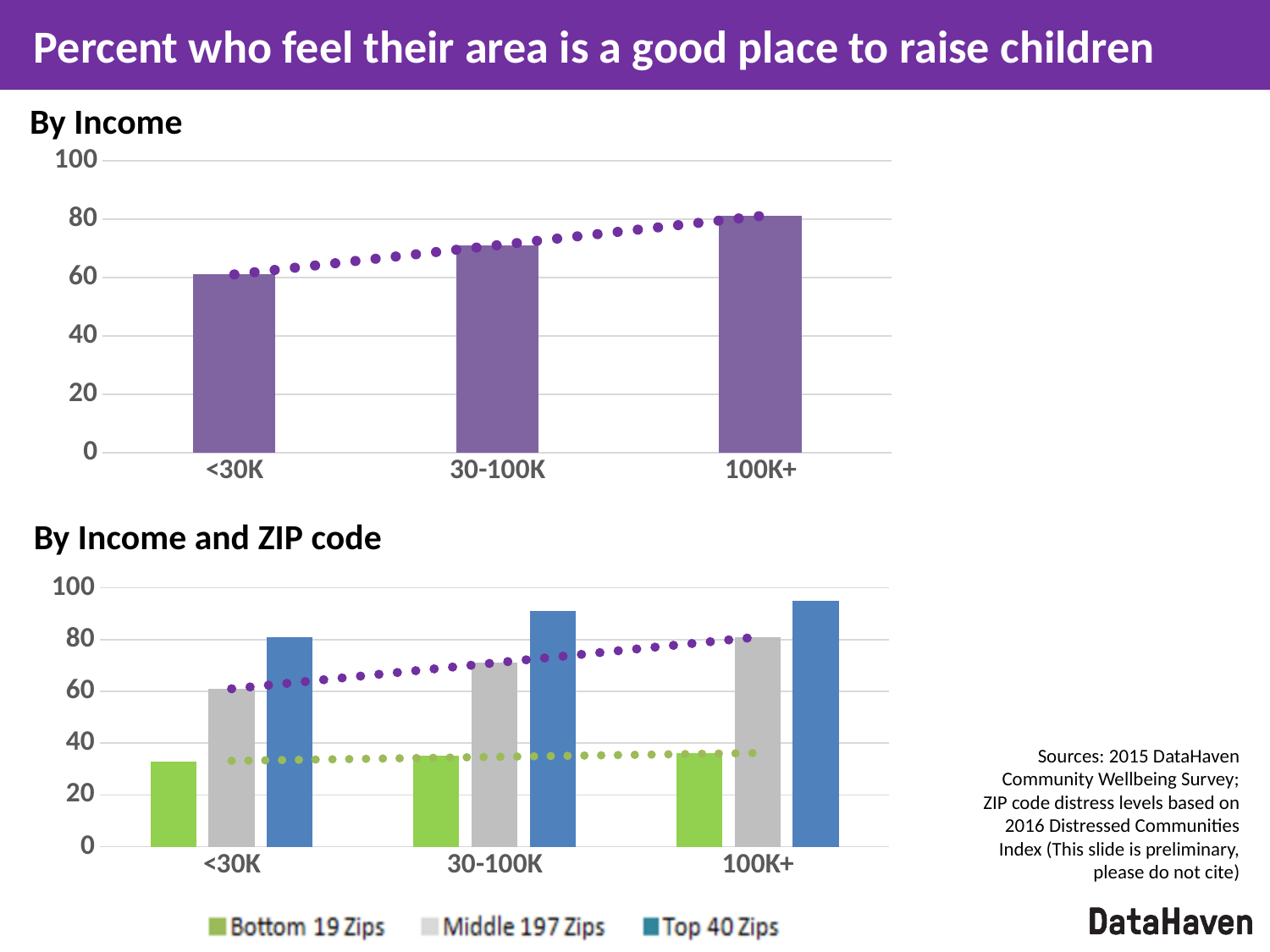
In the 'By Income and ZIP code' chart, is the value for Top 40 Zips at 100K+ greater or less than 80? greater What kind of chart is the 'By Income' chart? bar chart How many series does the legend of the 'By Income and ZIP code' chart list? 3 In the 'By Income' chart, which income group has the lowest value? <30K In the 'By Income' chart, do the values rise or fall as income increases from <30K to 100K+? rise In the 'By Income and ZIP code' chart, which series is shown in green? Bottom 19 Zips In the 'By Income and ZIP code' chart, which is larger for the <30K group: Top 40 Zips or Bottom 19 Zips? Top 40 Zips How many income categories are shown in the 'By Income' chart? 3 In the 'By Income' chart, which income group has the highest value? 100K+ In the 'By Income' chart, is the value for 100K+ greater or less than 60? greater In the 'By Income' chart, is the value for <30K greater or less than 80? less